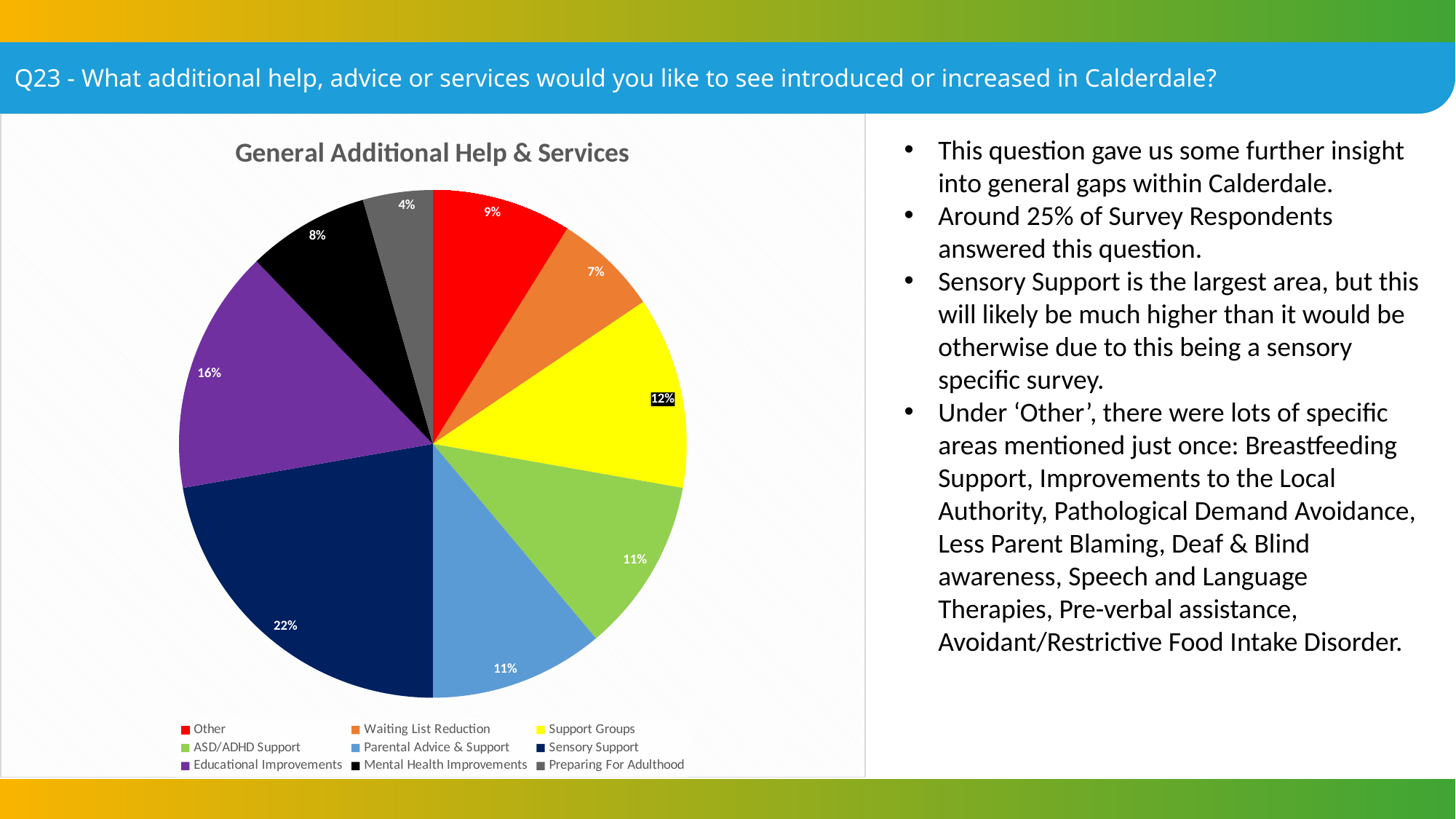
Which category has the smallest slice of the pie? Preparing For Adulthood What is the difference in percentage points between Sensory Support and Educational Improvements? 6 What type of chart is shown on the slide? Pie chart What is the title of the chart? General Additional Help & Services Which category has the largest slice of the pie? Sensory Support What percentage is shown for Waiting List Reduction? 7% What share of the pie does Sensory Support represent? 22% What colour is used for the Support Groups slice? Yellow What percentage is shown for Educational Improvements? 16% Which is larger, the slice for Other or the slice for Mental Health Improvements? Other What percentage is shown for Support Groups? 12% How many categories are shown in the pie chart? 9